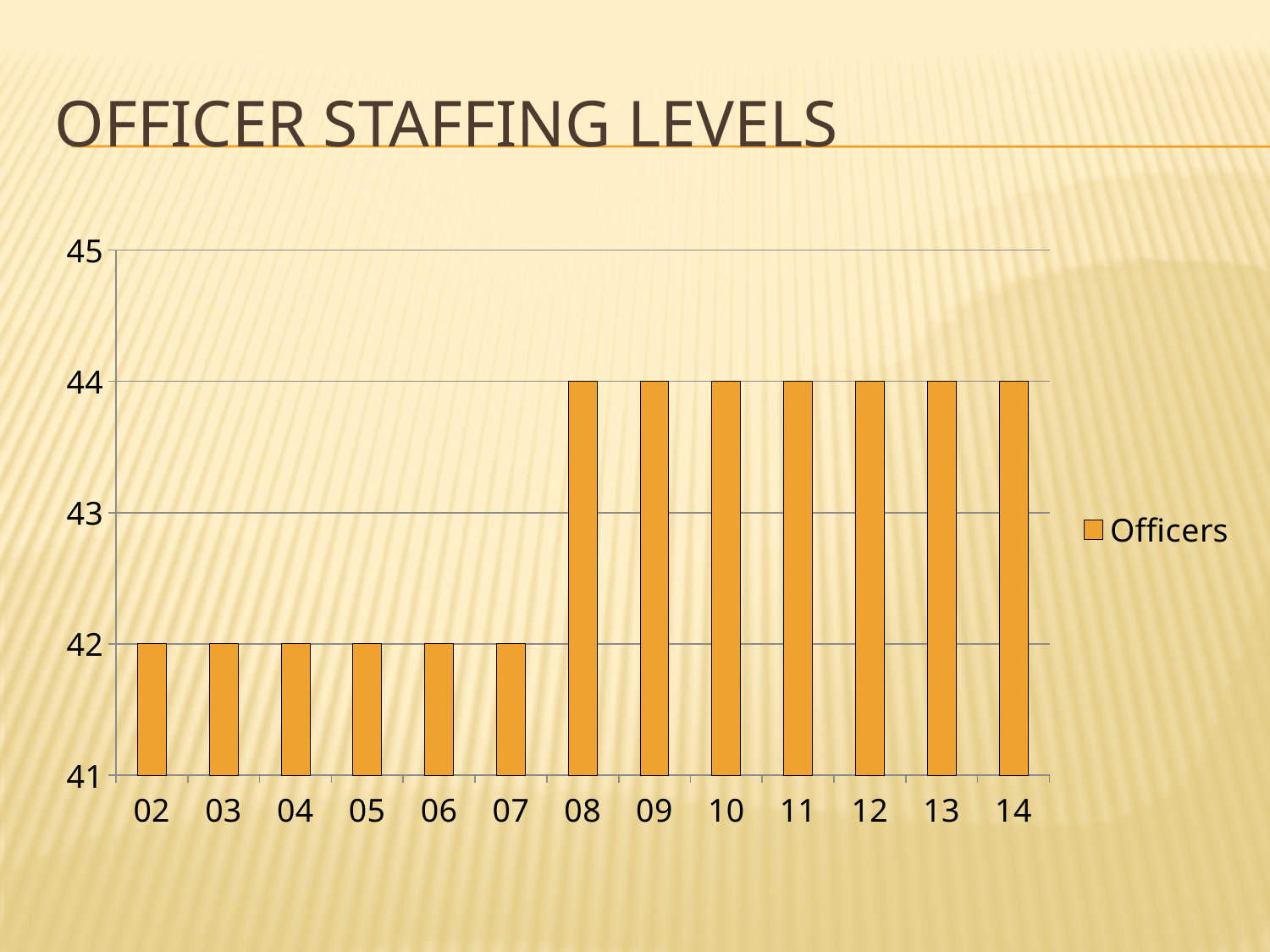
Is the value for 11 greater or less than 43? greater What is the value for 14? 44 How many series does the legend list? 1 Do the values rise or fall from 02 to 14? rise What is the value for 02? 42 Is the value for 05 greater or less than 43? less What is the difference between the values for 08 and 07? 2 What kind of chart is shown? bar chart What is the value for 07? 42 Which is larger, the value for 06 or the value for 09? 09 What is the value for 08? 44 How many categories are shown on the x axis? 13